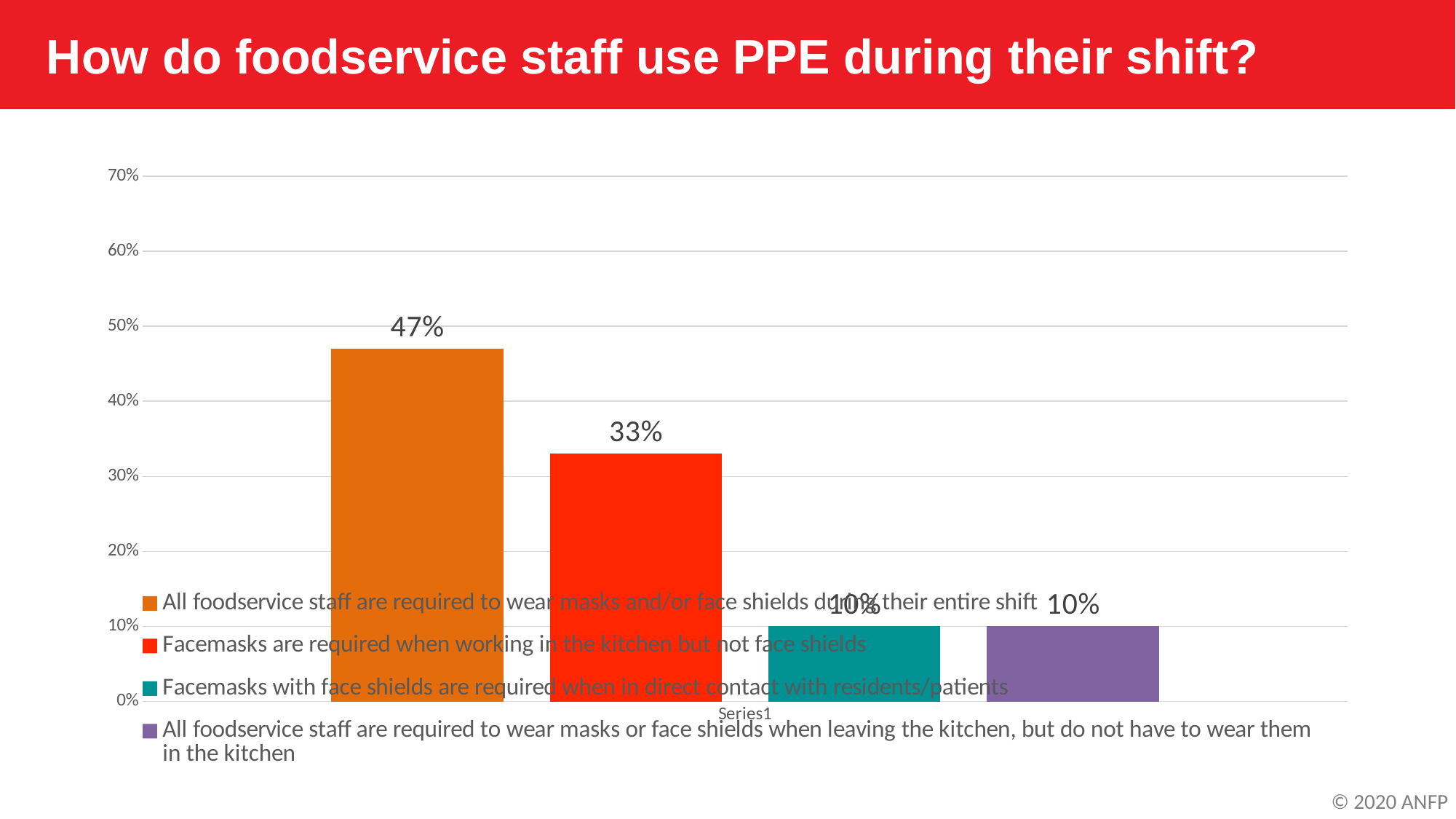
Is the value for 'Facemasks are required when working in the kitchen but not face shields' greater or less than 30%? greater How many entries does the legend list? 4 What is the difference in percentage points between the 'entire shift' response and the 'facemasks in the kitchen but not face shields' response? 14 percentage points How many bars are plotted in the chart? 4 What percentage of respondents said all foodservice staff are required to wear masks or face shields when leaving the kitchen, but do not have to wear them in the kitchen? 10% Which response has the highest percentage? All foodservice staff are required to wear masks and/or face shields during their entire shift What kind of chart is shown on the slide? Bar chart Which is larger: the percentage for facemasks required in the kitchen but not face shields, or the percentage for facemasks with face shields required in direct contact with residents/patients? Facemasks are required when working in the kitchen but not face shields What colour is the bar for 'Facemasks with face shields are required when in direct contact with residents/patients'? Teal What percentage of respondents said all foodservice staff are required to wear masks and/or face shields during their entire shift? 47% What percentage of respondents said facemasks are required when working in the kitchen but not face shields? 33% What percentage of respondents said facemasks with face shields are required when in direct contact with residents/patients? 10%